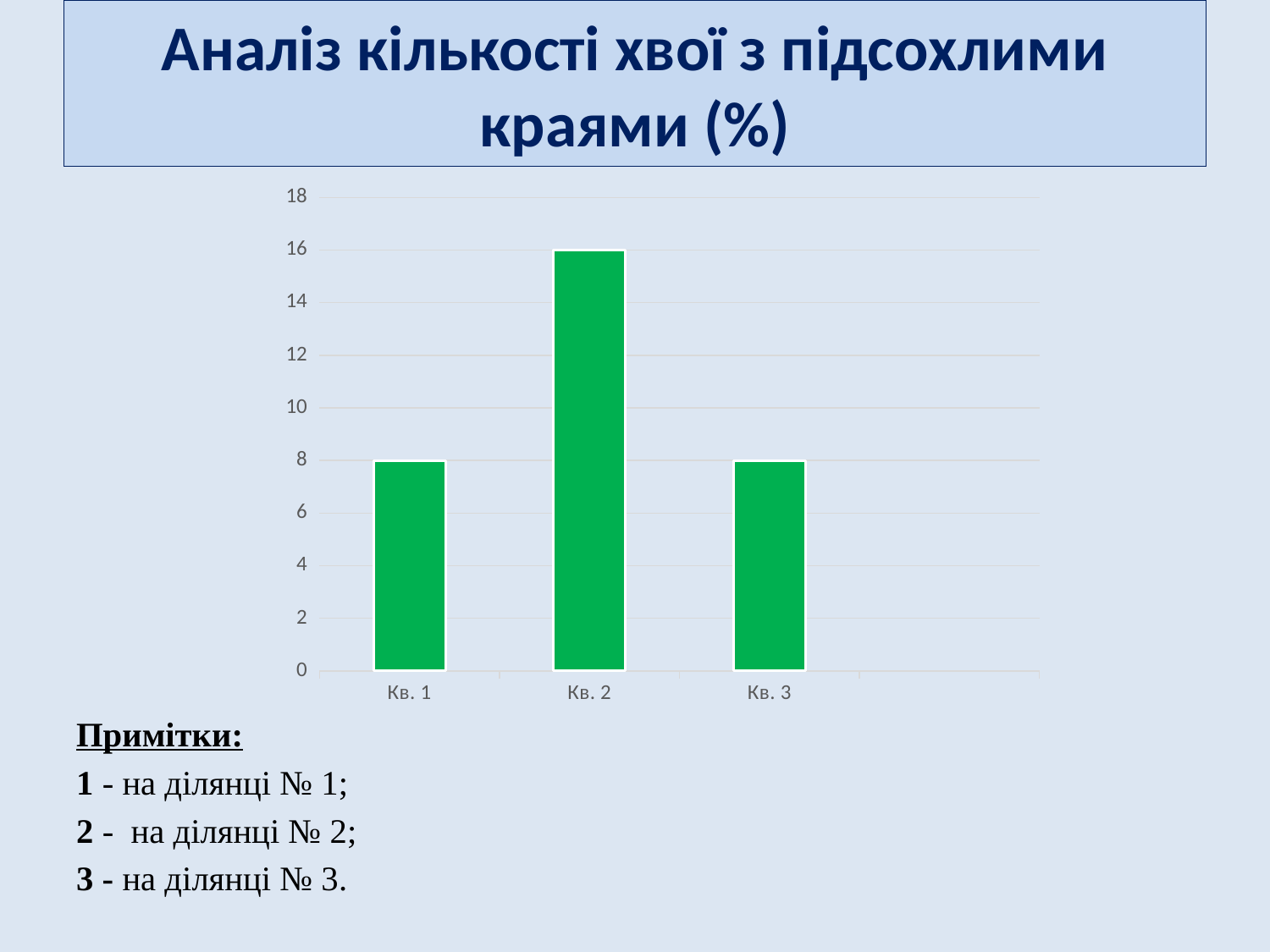
What is the value for Кв. 3? 8 Which is larger, the value for Кв. 1 or the value for Кв. 2? Кв. 2 What is the value for Кв. 1? 8 Is the value for Кв. 1 greater or less than 12? less Does the value rise or fall from Кв. 2 to Кв. 3? fall What is the title of the slide above the chart? Аналіз кількості хвої з підсохлими краями (%) Is the value for Кв. 2 greater or less than 10? greater What kind of chart is shown on the slide? bar chart What is the difference between the values for Кв. 2 and Кв. 3? 8 Which category has the highest value? Кв. 2 How many categories are shown on the x axis? 3 What is the value for Кв. 2? 16